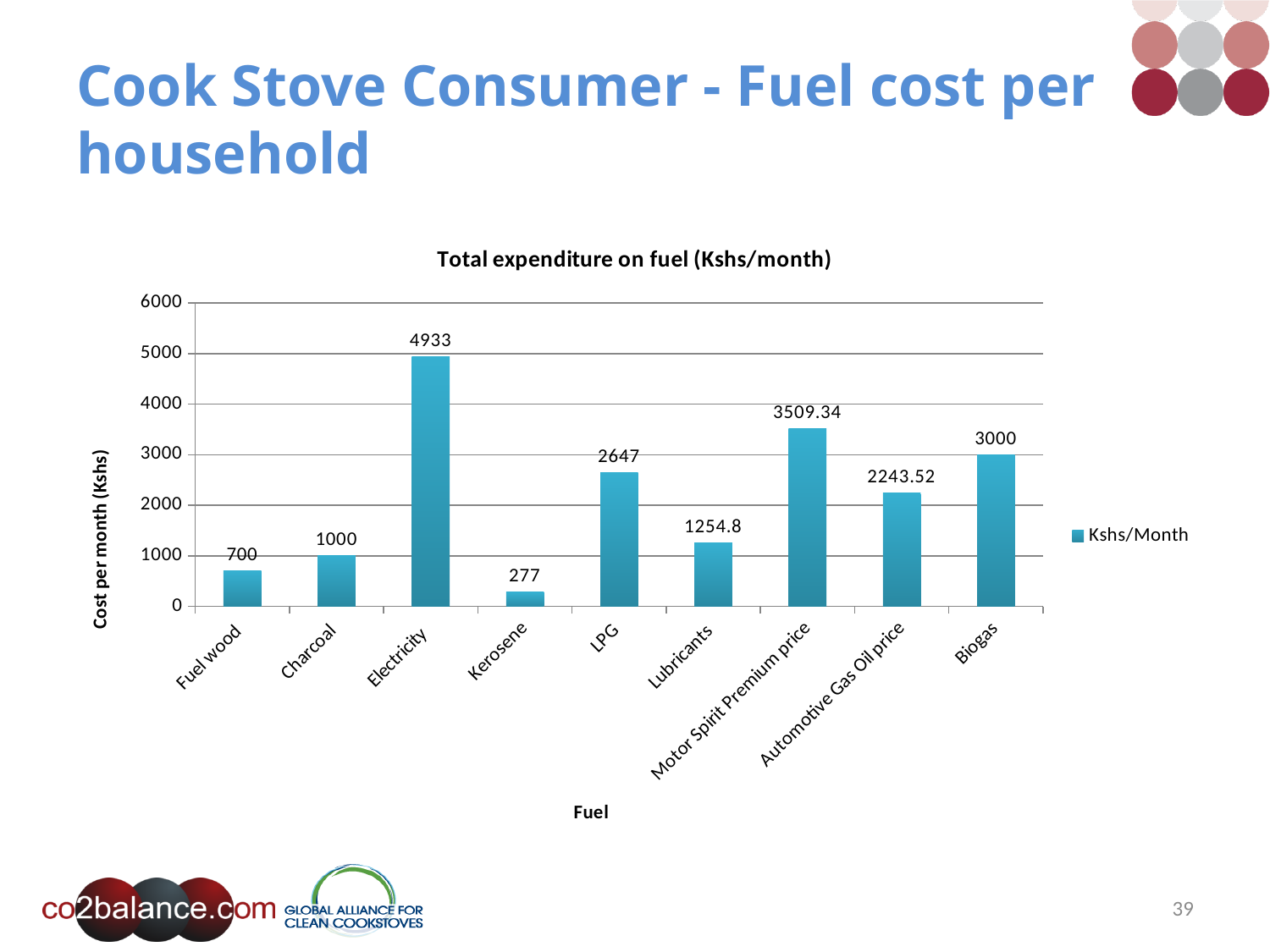
What is the value for Electricity? 4933 How many series does the legend list? 1 What is the value for Lubricants? 1254.8 What is the title of the chart? Total expenditure on fuel (Kshs/month) What is the value for Motor Spirit Premium price? 3509.34 What kind of chart is shown? Bar chart How many fuel categories are shown on the x axis? 9 What is the difference between the values for Electricity and Biogas? 1933 Which fuel has the highest total expenditure? Electricity Which is larger, the value for LPG or the value for Automotive Gas Oil price? LPG What is the difference between the values for Charcoal and Fuel wood? 300 Which fuel has the lowest total expenditure? Kerosene